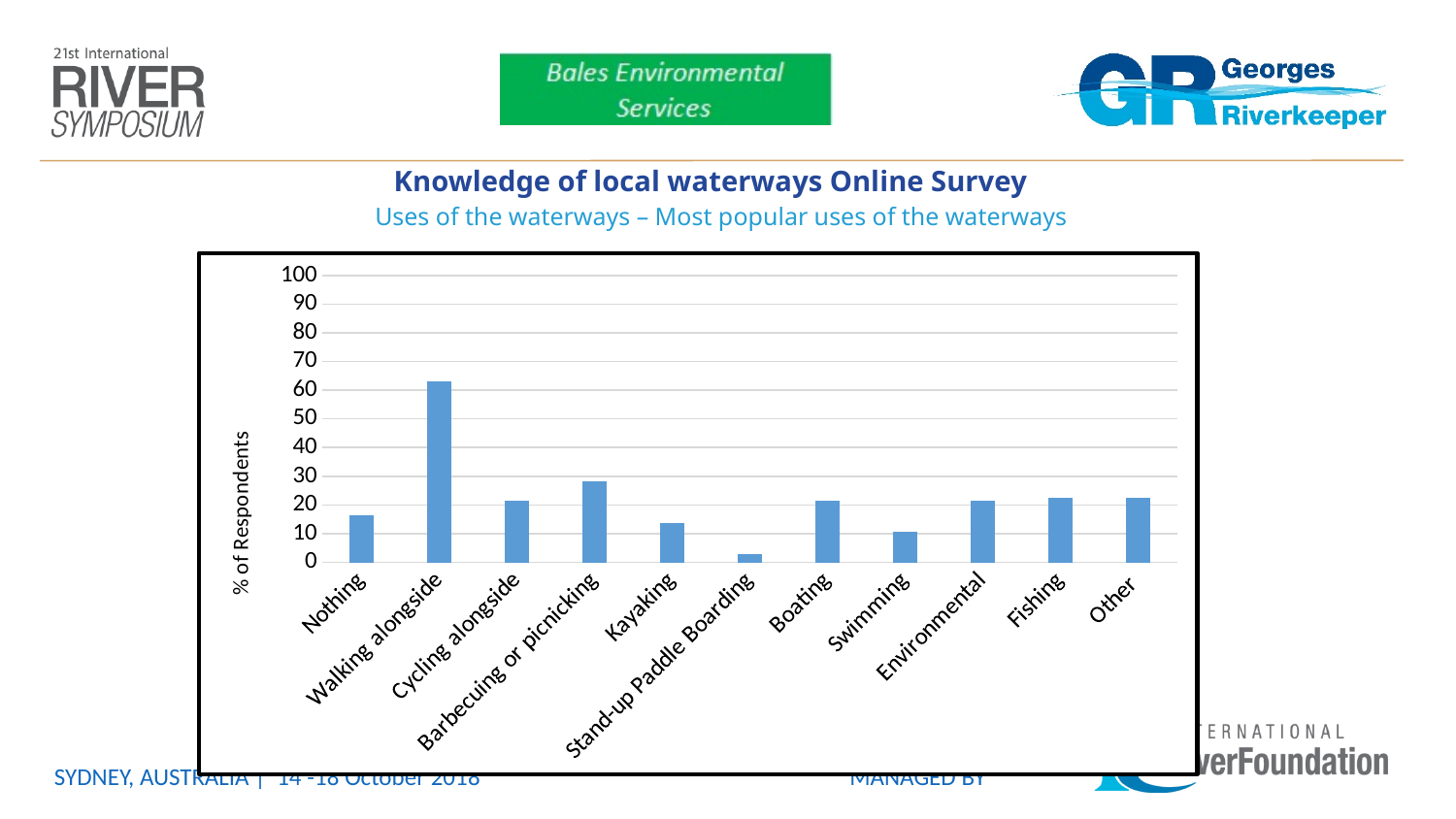
Which has a higher percentage of respondents, Barbecuing or picnicking or Kayaking? Barbecuing or picnicking Is the value for Kayaking greater or less than 20? less Which use of the waterways has the lowest percentage of respondents? Stand-up Paddle Boarding Which use of the waterways has the highest percentage of respondents? Walking alongside Is the value for Stand-up Paddle Boarding greater or less than 10? less What is the label on the vertical axis of the chart? % of Respondents How many categories (uses of the waterways) are shown on the x axis? 11 Is the value for Barbecuing or picnicking greater or less than 20? greater Which has a higher percentage of respondents, Nothing or Swimming? Nothing What kind of chart is shown on the slide? Bar chart